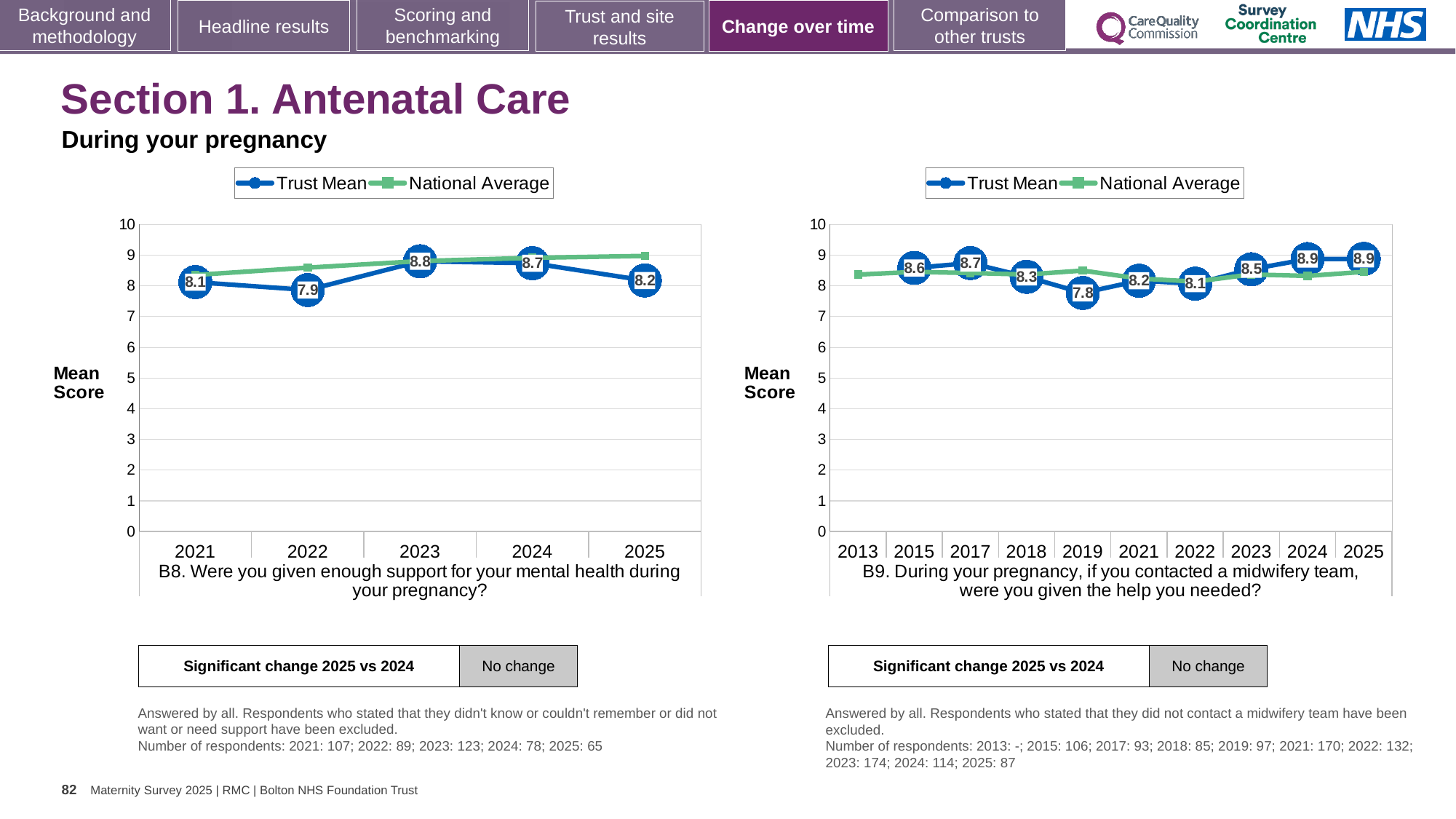
On the left chart (B8), how many years are shown on the x axis? 5 On the left chart (B8), what is the Trust Mean for 2023? 8.8 On the left chart (B8), does the Trust Mean rise or fall from 2024 to 2025? fall On the left chart (B8), what is the difference between the Trust Mean in 2023 and in 2022? 0.9 On the right chart (B9), what is the Trust Mean for 2021? 8.2 On the left chart (B8), is the National Average for 2025 greater or less than 8? greater On the right chart (B9), which is larger, the Trust Mean for 2015 or for 2018? 2015 On the right chart (B9), which year has the lowest Trust Mean? 2019 How many series does the legend of the right chart (B9) list? 2 On the left chart (B8), which year has the lowest Trust Mean? 2022 On the left chart (B8), which year has the highest Trust Mean? 2023 On the right chart (B9), what is the difference between the Trust Mean in 2025 and in 2019? 1.1